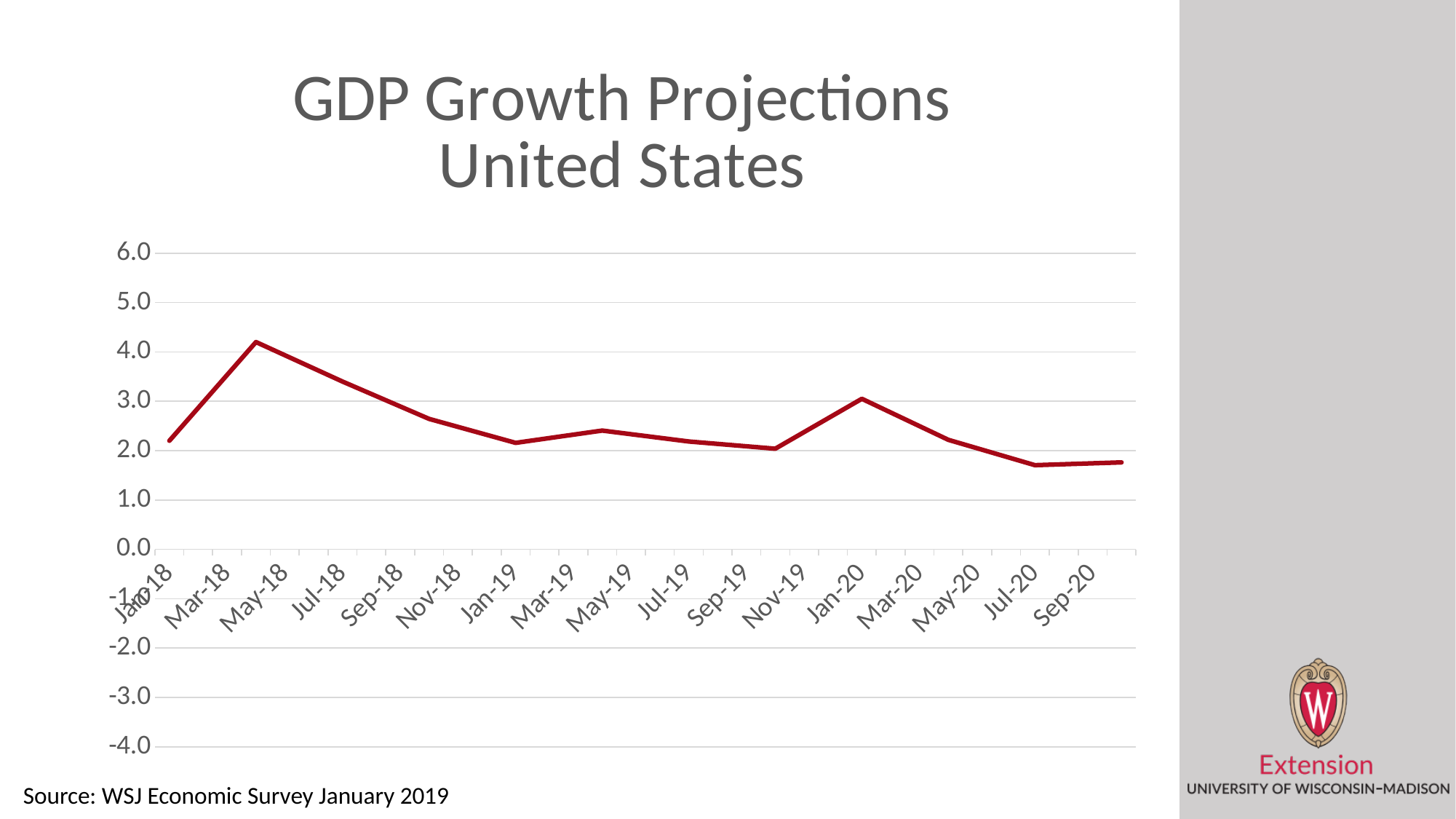
What kind of chart is shown on the slide? line chart Is the value for Jan-20 greater or less than 2.0? greater Which is higher, the value for Jan-18 or the value for Jan-20? Jan-20 Which is higher, the value for Jan-19 or the value for Jul-20? Jan-19 What source is cited for the chart? WSJ Economic Survey January 2019 Is the highest point on the line greater or less than 4.0? greater Is the value for Jul-20 greater or less than 2.0? less What is the title of the chart? GDP Growth Projections United States How many month labels are shown on the x axis? 17 Does the line rise or fall between May-18 and Jan-19? fall